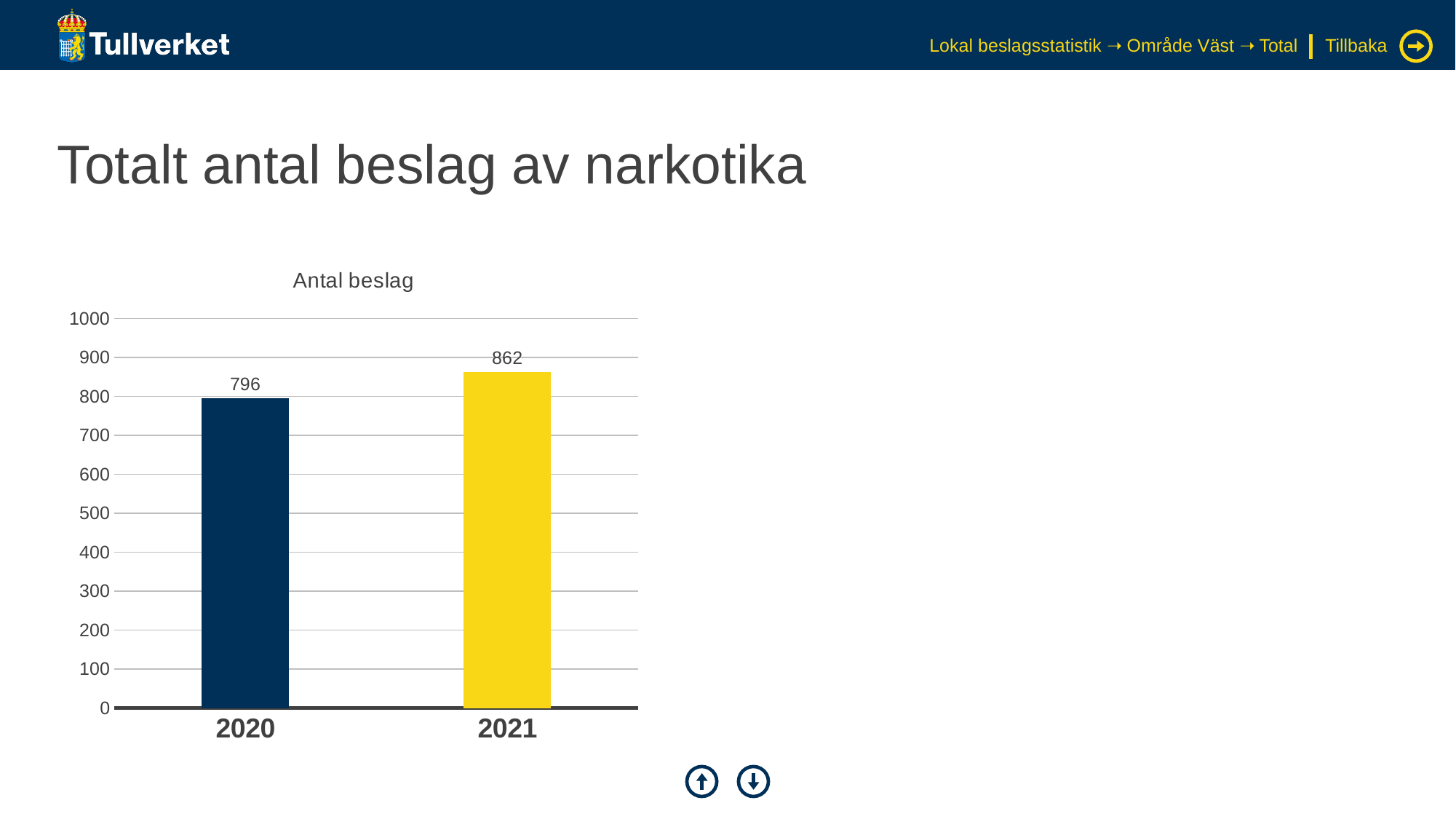
Do the values in the Antal beslag chart rise or fall from 2020 to 2021? rise Which is larger in the Antal beslag chart, the value for 2020 or the value for 2021? 2021 How many years are shown on the x axis of the Antal beslag chart? 2 Which year has the lowest value in the Antal beslag chart? 2020 Which year has the highest value in the Antal beslag chart? 2021 What is the title of the chart on the slide? Antal beslag What is the value for 2020 in the Antal beslag chart? 796 Is the value for 2021 in the Antal beslag chart greater or less than 900? less What is the value for 2021 in the Antal beslag chart? 862 What kind of chart is shown on the slide? bar chart Is the value for 2020 in the Antal beslag chart greater or less than 800? less What is the difference between the values for 2021 and 2020 in the Antal beslag chart? 66